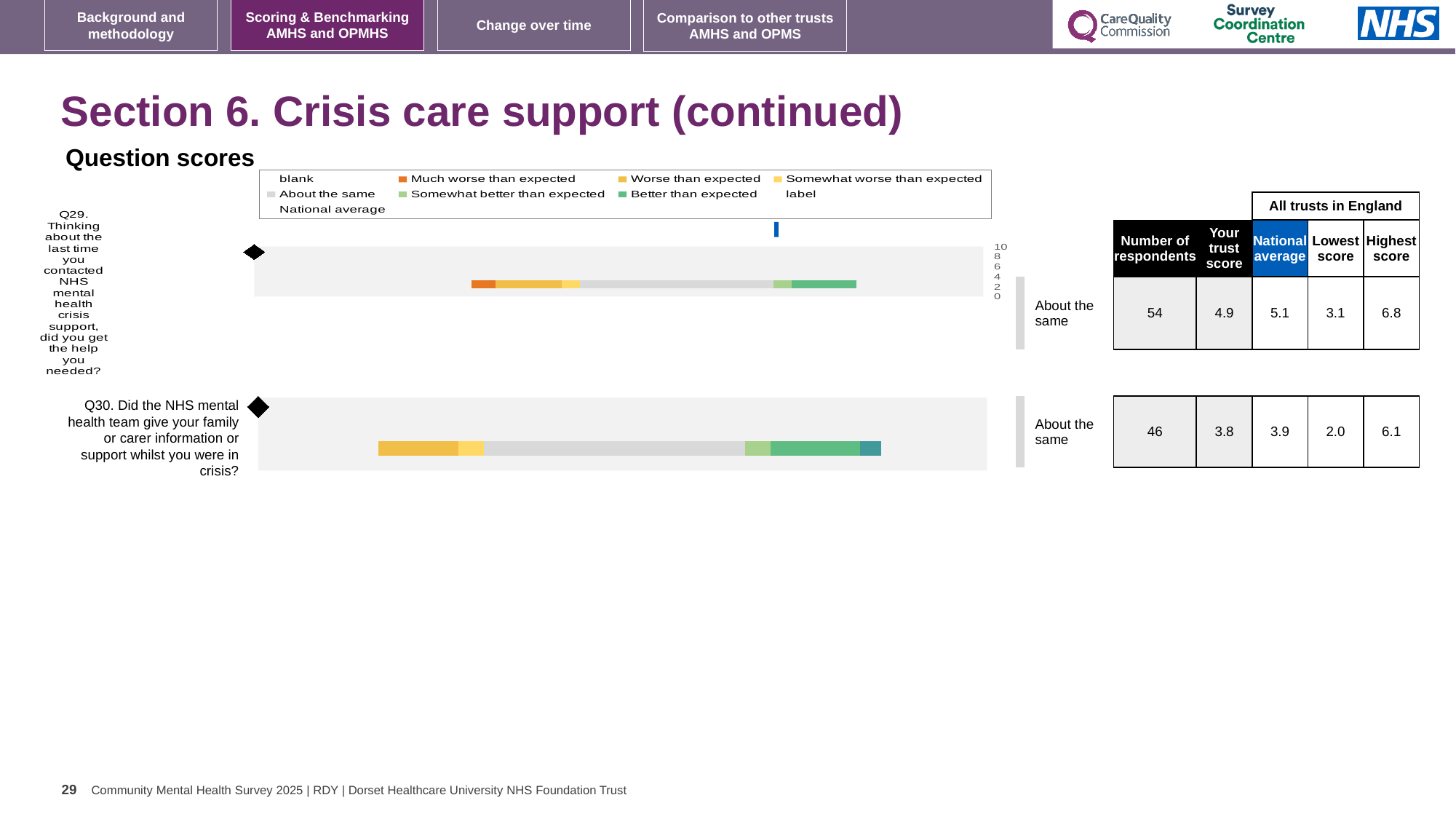
What is the lowest score across all trusts in England for Q29? 3.1 What is the difference between the highest and lowest scores for Q29? 3.7 What benchmark category is the trust's score for Q30 placed in? About the same What is the highest score across all trusts in England for Q30? 6.1 What is the trust score for Q29 shown next to the chart? 4.9 Which question has the higher trust score, Q29 or Q30? Q29 How many questions are plotted in the question scores chart? 2 What is the difference between the national average and the trust score for Q30? 0.1 What is the national average for Q30 shown next to the chart? 3.9 How many respondents answered Q29? 54 Which legend entry is shown in orange? Much worse than expected What kind of chart is used to show the question scores for Q29 and Q30? bar chart